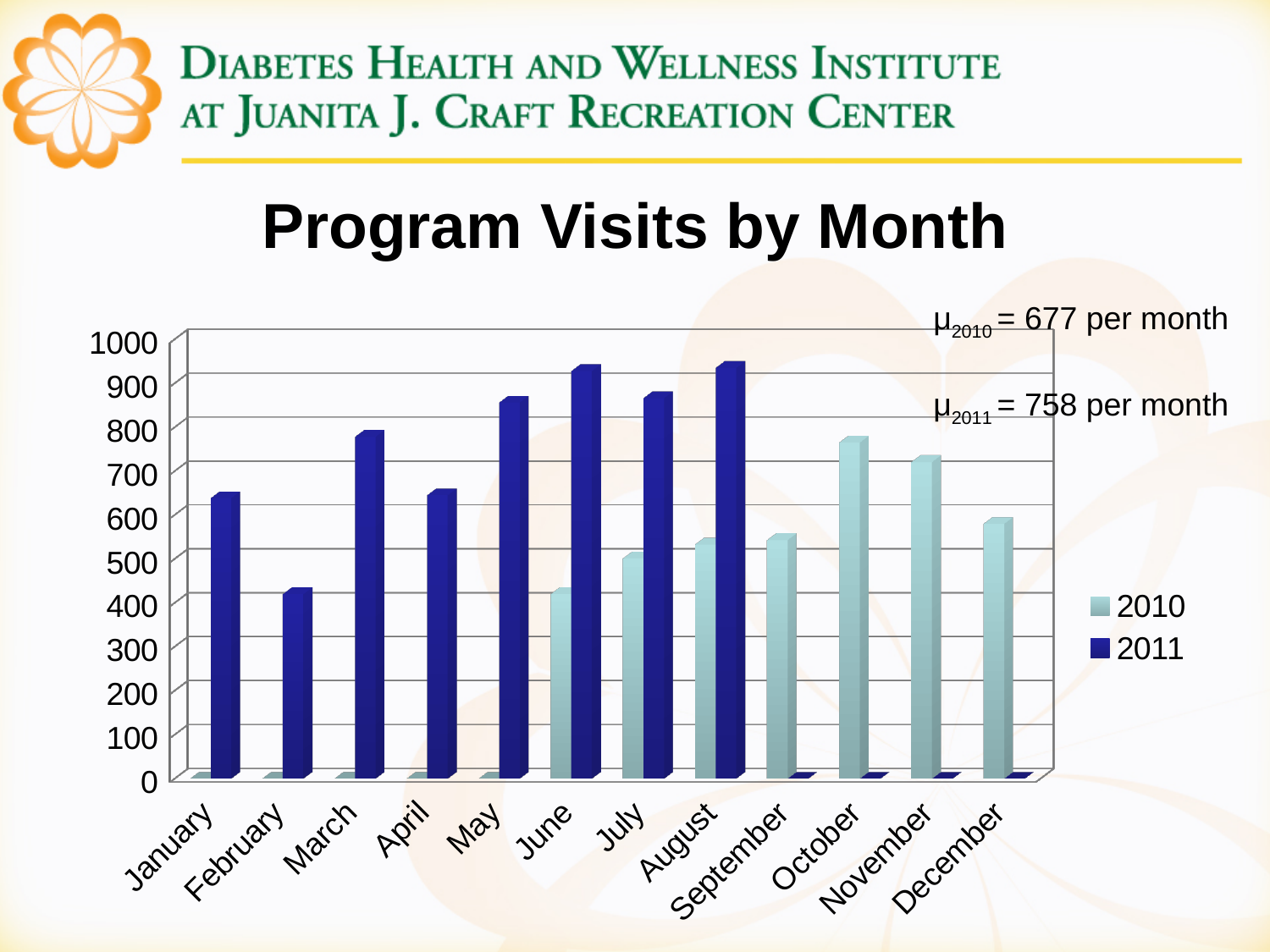
Is the 2011 value for March greater or less than 700? greater How many months are shown along the x axis? 12 Which month has the lowest value for the 2010 series? June Is the 2010 value for October greater or less than 700? greater Which month has the lowest value for the 2011 series? February What is the title of the chart? Program Visits by Month How many series does the legend list? 2 Which month has the highest value for the 2010 series? October What kind of chart is shown on the slide? bar chart Which is larger for August: the 2010 value or the 2011 value? 2011 According to the text on the slide, what is the mean number of visits per month for 2011? 758 per month Is the 2011 value for February greater or less than 500? less